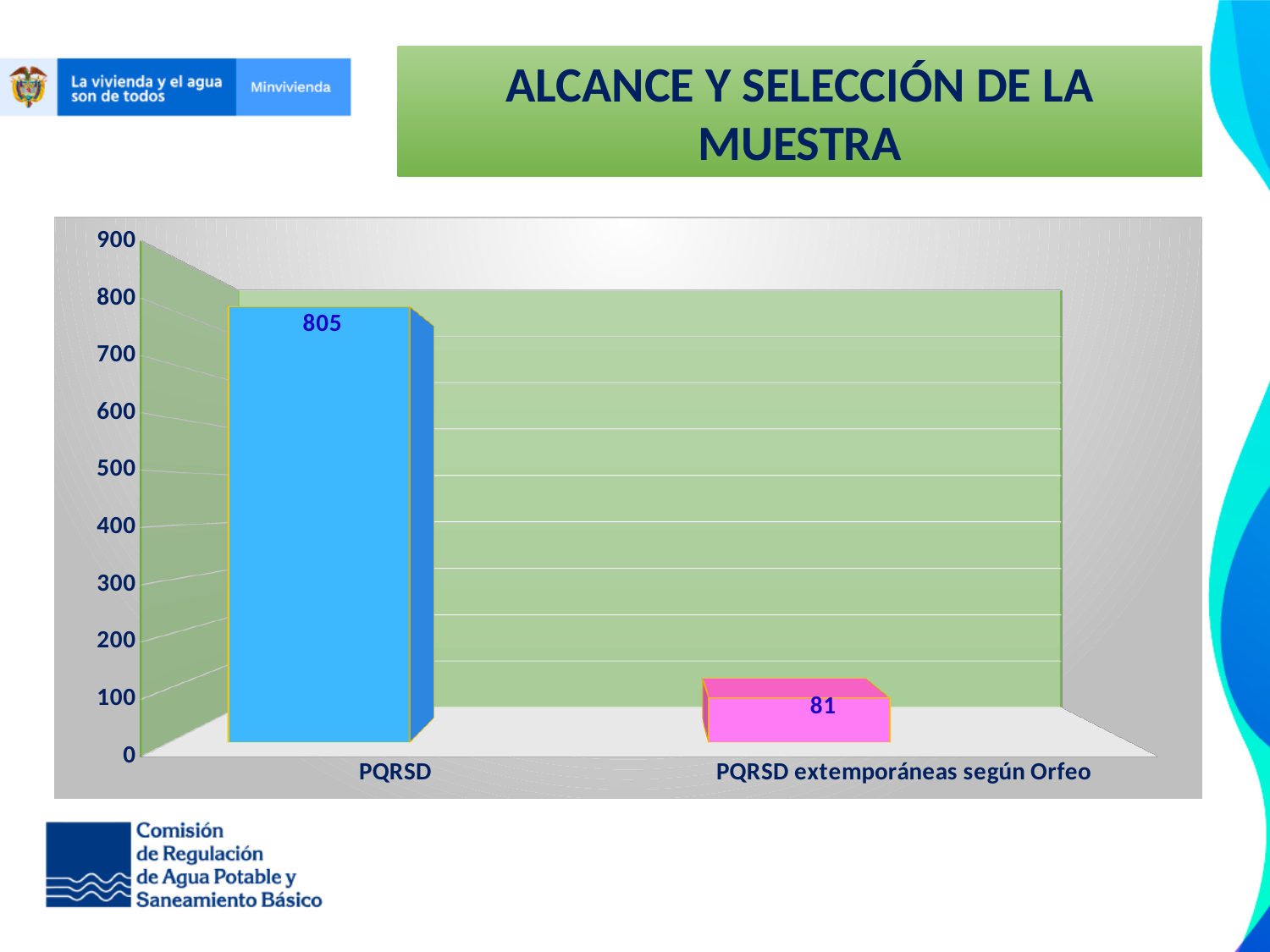
How many categories are shown on the chart? 2 What is the highest value shown on the vertical axis? 900 What is the value for PQRSD extemporáneas según Orfeo? 81 What is the value for PQRSD? 805 Which is larger, the value for PQRSD or the value for PQRSD extemporáneas según Orfeo? PQRSD Which category has the lowest value? PQRSD extemporáneas según Orfeo What kind of chart is shown on the slide? bar chart What is the difference between the value for PQRSD and the value for PQRSD extemporáneas según Orfeo? 724 What colour is the bar for PQRSD extemporáneas según Orfeo? pink Is the value for PQRSD extemporáneas según Orfeo greater or less than 100? less Which category has the highest value? PQRSD Is the value for PQRSD greater or less than 700? greater